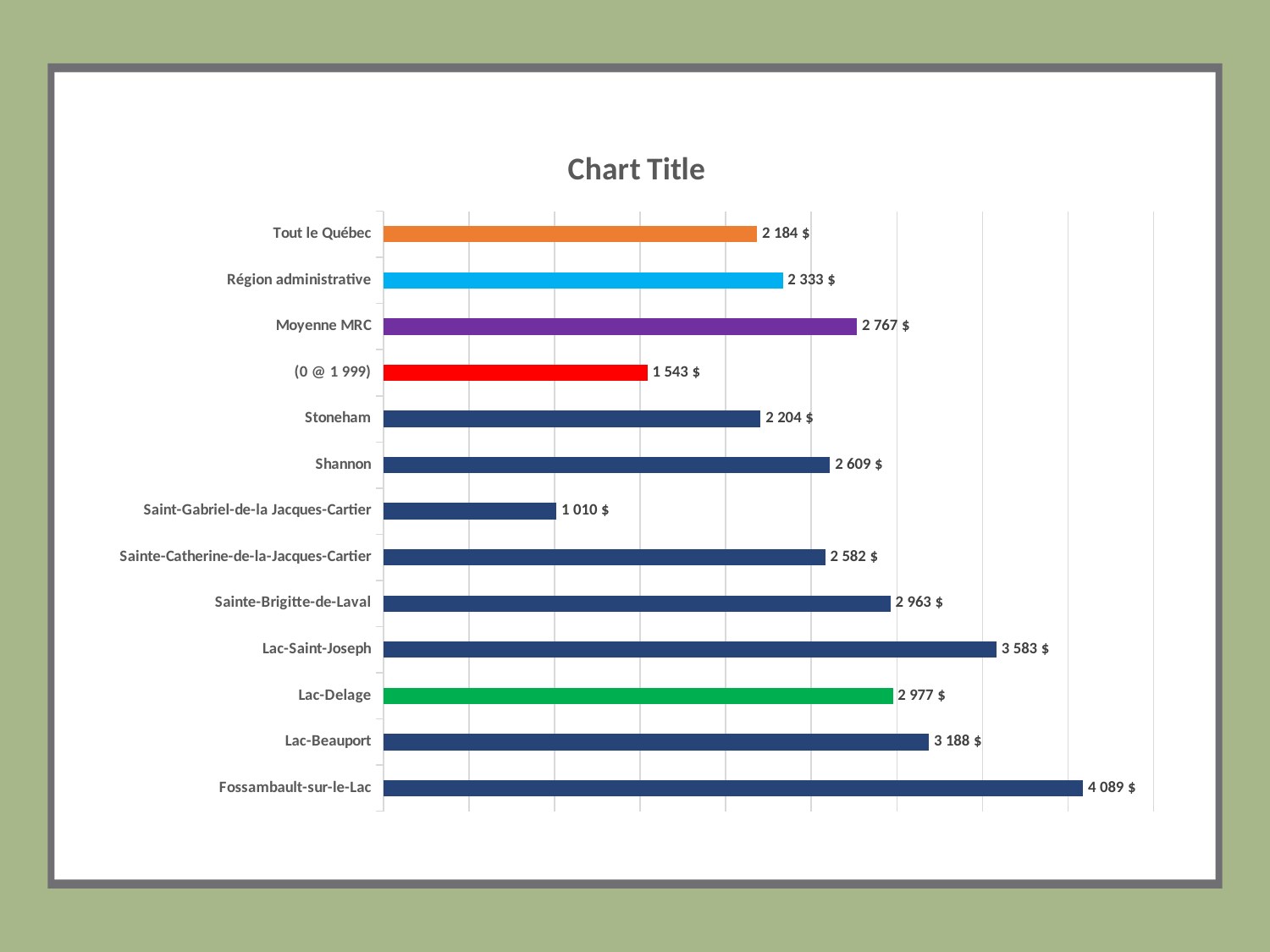
Which category has the highest value? Fossambault-sur-le-Lac What is the value for Fossambault-sur-le-Lac? 4 089 $ What is the difference between the values for Fossambault-sur-le-Lac and Lac-Saint-Joseph? 506 $ How many categories are shown in the chart? 13 What is the difference between the values for Moyenne MRC and Tout le Québec? 583 $ What is the value for Tout le Québec? 2 184 $ What is the value for Moyenne MRC? 2 767 $ What is the value for Stoneham? 2 204 $ Which category has the lowest value? Saint-Gabriel-de-la Jacques-Cartier What colour is the bar for Lac-Delage? Green Which is larger, the value for Lac-Beauport or the value for Lac-Saint-Joseph? Lac-Saint-Joseph What kind of chart is shown on the slide? Bar chart